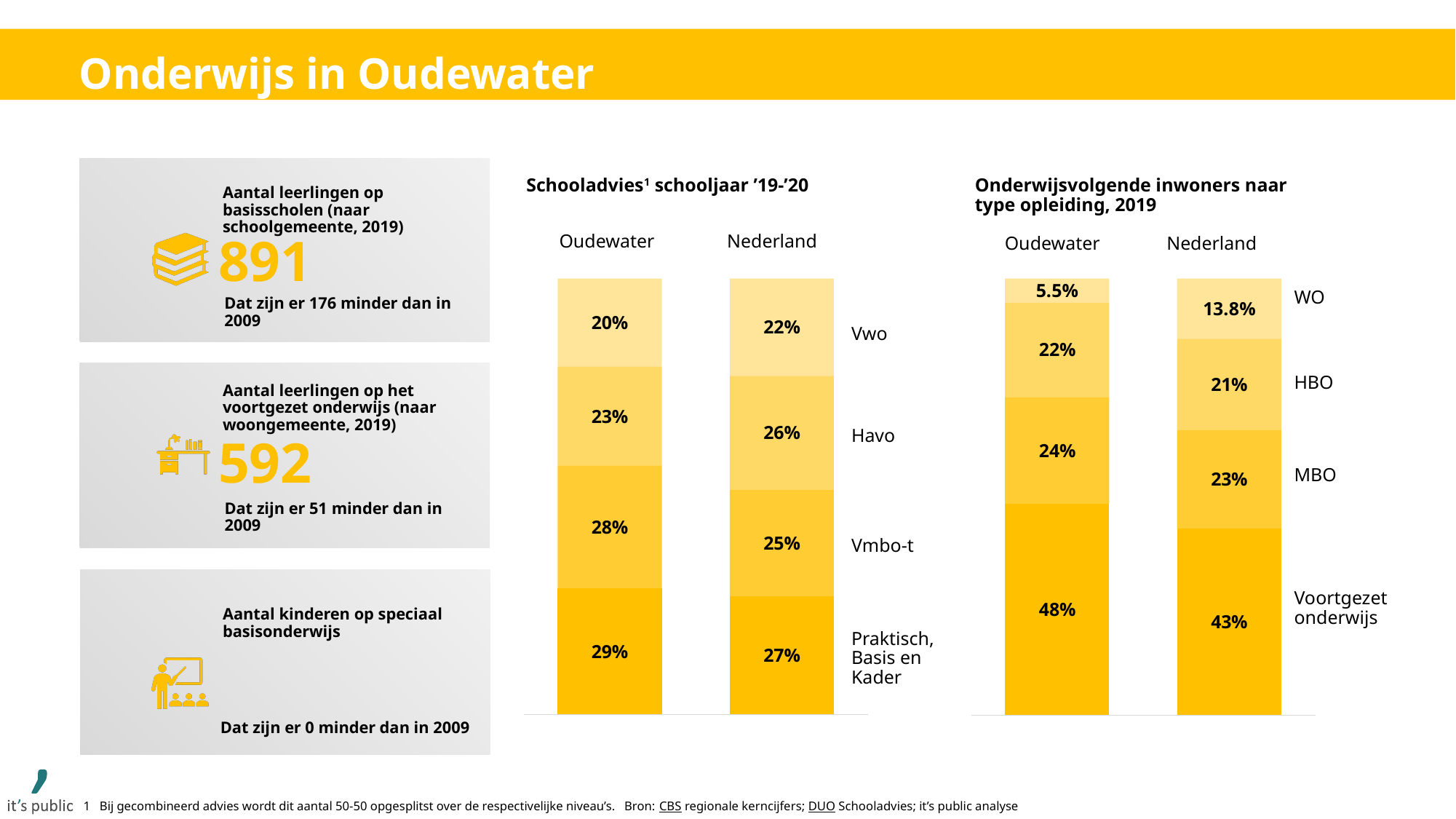
How many segments does each stacked bar have in the 'Onderwijsvolgende inwoners naar type opleiding, 2019' chart? 4 In the 'Schooladvies schooljaar '19-'20' chart, which has the larger Havo share, Oudewater or Nederland? Nederland What kind of chart is the 'Schooladvies schooljaar '19-'20' chart? Stacked bar chart In the 'Schooladvies schooljaar '19-'20' chart, what is the Havo share for Nederland? 26% In the 'Onderwijsvolgende inwoners naar type opleiding, 2019' chart, which category has the smallest share in the Oudewater bar? WO In the 'Onderwijsvolgende inwoners naar type opleiding, 2019' chart, what is the Voortgezet onderwijs share for Nederland? 43% In the 'Schooladvies schooljaar '19-'20' chart, which category has the smallest share in the Nederland bar? Vwo In the 'Onderwijsvolgende inwoners naar type opleiding, 2019' chart, what is the WO share for Oudewater? 5.5% In the 'Schooladvies schooljaar '19-'20' chart, which category has the largest share in the Oudewater bar? Praktisch, Basis en Kader In the 'Schooladvies schooljaar '19-'20' chart, what is the difference between the Vmbo-t shares of Oudewater and Nederland? 3% In the 'Onderwijsvolgende inwoners naar type opleiding, 2019' chart, what is the difference between the HBO shares of Oudewater and Nederland? 1% In the 'Schooladvies schooljaar '19-'20' chart, what is the Vwo share for Oudewater? 20%